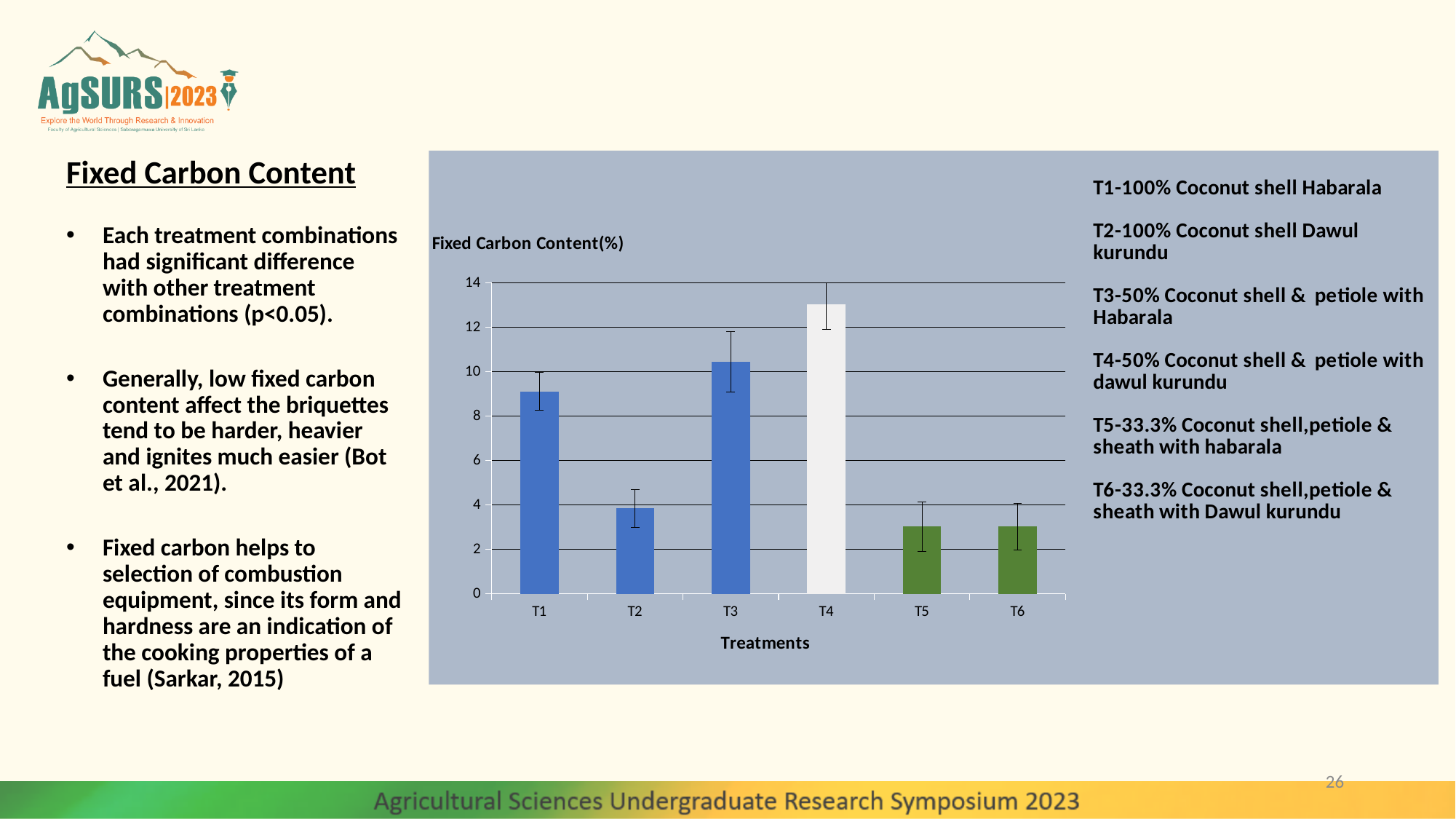
Which treatment has the highest fixed carbon content? T4 Is the fixed carbon content for T4 greater or less than 12? greater Which has a higher fixed carbon content, T3 or T4? T4 What is the label of the x axis of the chart? Treatments What quantity does the chart's vertical axis represent, according to the label above it? Fixed Carbon Content(%) Is the fixed carbon content for T5 greater or less than 4? less How many treatments are plotted on the x axis of the chart? 6 Is the fixed carbon content for T1 greater or less than 8? greater What kind of chart is shown on the slide? bar chart Which has a higher fixed carbon content, T1 or T2? T1